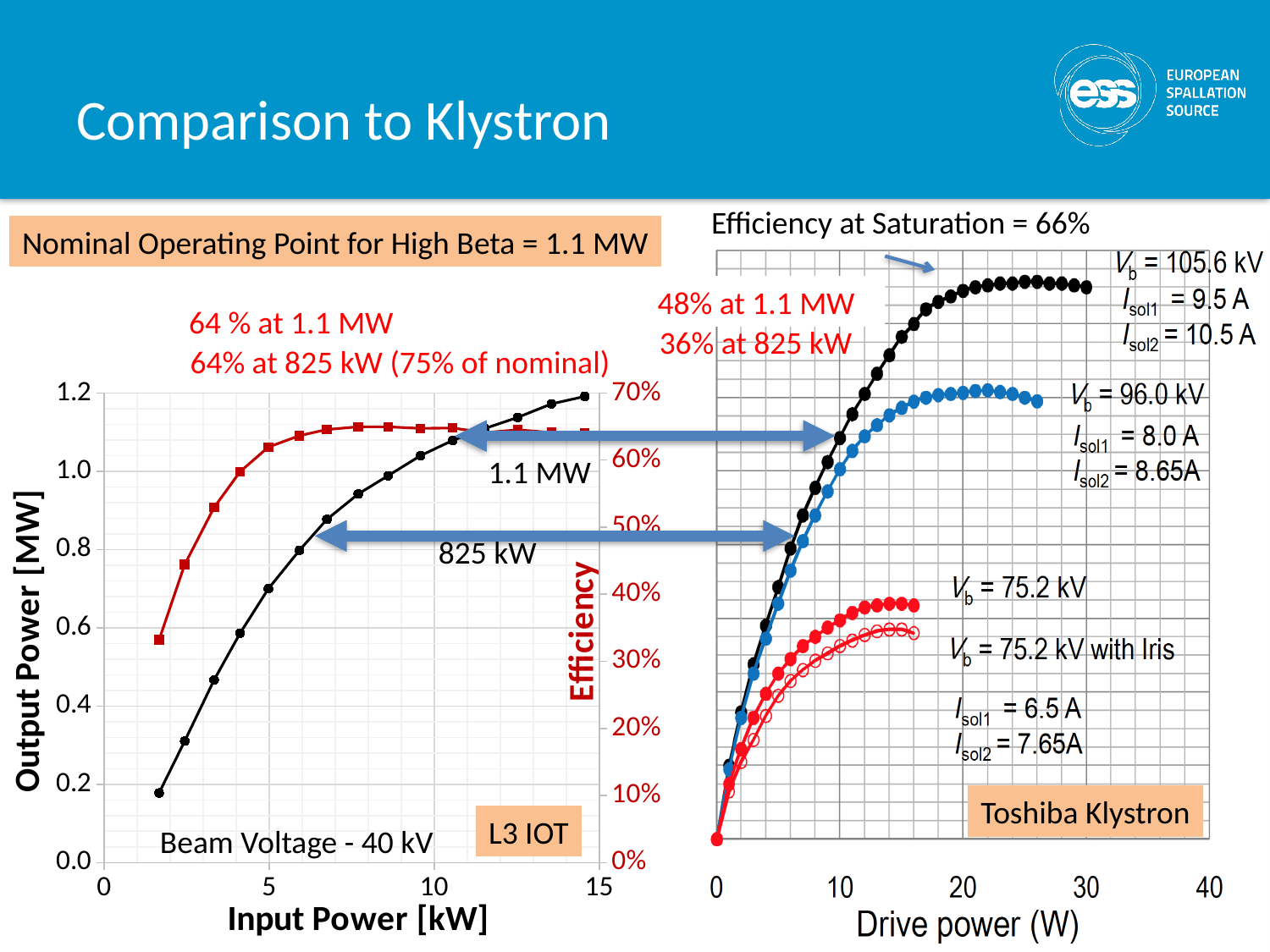
What kind of chart is the L3 IOT chart on the left of the slide? line chart On the L3 IOT chart, does the output power rise or fall as input power increases? rises On the L3 IOT chart, what is the label of the x axis? Input Power [kW] At 825 kW, which has the higher efficiency, the L3 IOT or the Toshiba Klystron? L3 IOT What is the efficiency at saturation stated for the Toshiba Klystron chart? 66% What is the difference between the L3 IOT efficiency and the Toshiba Klystron efficiency at 1.1 MW? 16% According to the slide, what is the efficiency of the Toshiba Klystron at 825 kW? 36% According to the slide, what is the efficiency of the Toshiba Klystron at 1.1 MW? 48% On the L3 IOT chart, is the output power at an input power of 5 kW greater or less than 1.0 MW? less On the Toshiba Klystron chart, which beam voltage curve reaches the highest output? Vb = 105.6 kV According to the slide, what is the efficiency of the L3 IOT at 1.1 MW? 64 % On the Toshiba Klystron chart, what is the label of the x axis? Drive power (W)